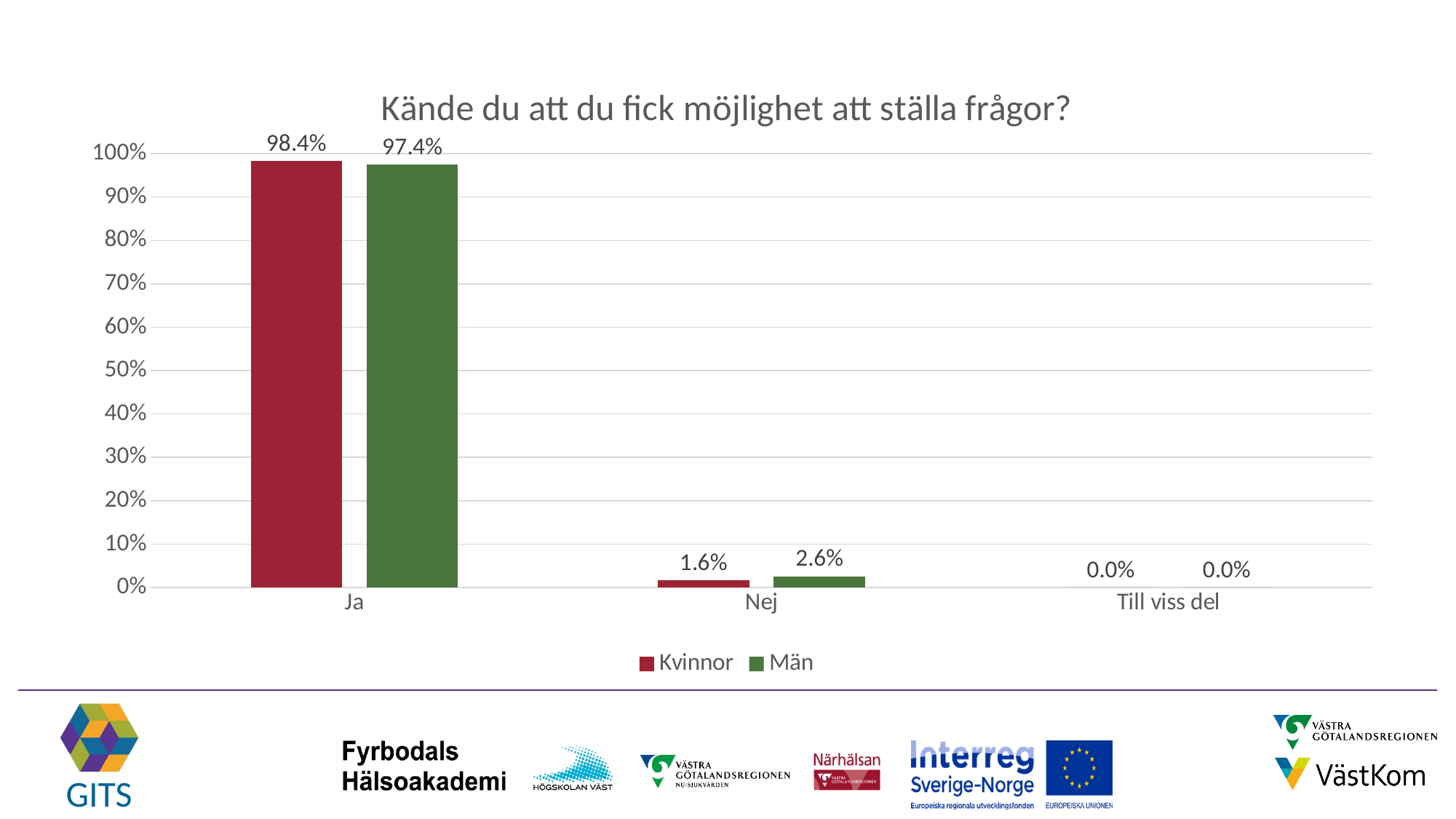
What is the value for Män in the Nej category? 2.6% Which category has the highest value for Män? Ja What is the difference between the Män and Kvinnor values in the Nej category? 1.0% What is the value for Kvinnor in the Ja category? 98.4% What is the value for Kvinnor in the Till viss del category? 0.0% How many categories are shown on the x axis? 3 In the Nej category, which series has the larger value, Kvinnor or Män? Män What is the value for Män in the Ja category? 97.4% What is the value for Kvinnor in the Nej category? 1.6% What kind of chart is shown on the slide? Bar chart How many series does the legend list? 2 What is the difference between the Kvinnor and Män values in the Ja category? 1.0%